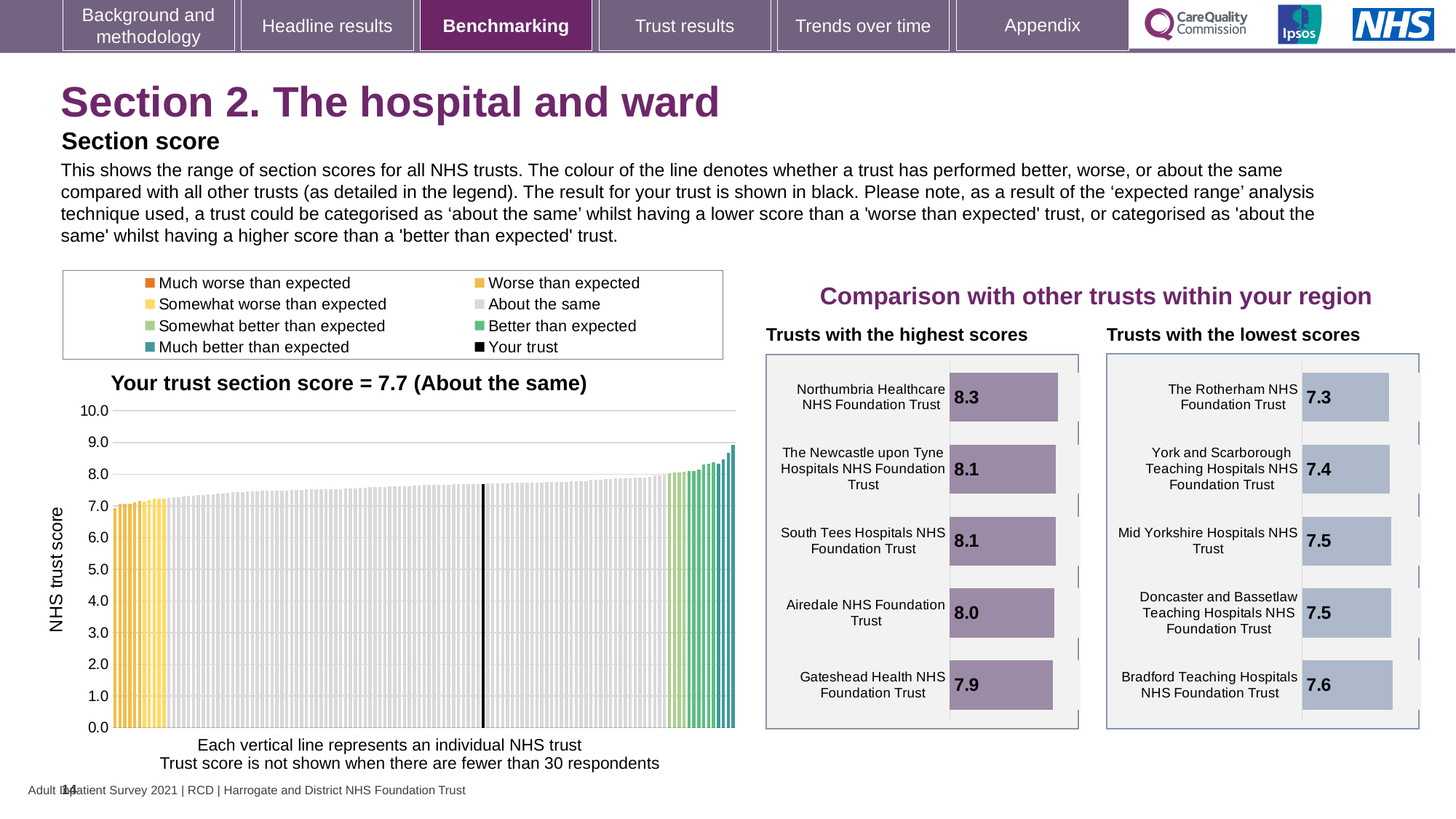
In the 'Trusts with the highest scores' chart, which trust has the highest score? Northumbria Healthcare NHS Foundation Trust In the main 'NHS trust score' chart, is the value for your trust greater or less than 5.0? greater In the main 'NHS trust score' chart, what is your trust's section score? 7.7 In the 'Trusts with the highest scores' chart, which has the larger score: Airedale NHS Foundation Trust or Gateshead Health NHS Foundation Trust? Airedale NHS Foundation Trust How many entries does the legend of the main 'NHS trust score' chart list? 8 In the 'Trusts with the highest scores' chart, what is the score for Northumbria Healthcare NHS Foundation Trust? 8.3 In the 'Trusts with the lowest scores' chart, which trust has the lowest score? The Rotherham NHS Foundation Trust In the 'Trusts with the lowest scores' chart, what is the difference between the scores of Bradford Teaching Hospitals NHS Foundation Trust and The Rotherham NHS Foundation Trust? 0.3 In the 'Trusts with the highest scores' chart, what is the difference between the scores of Northumbria Healthcare NHS Foundation Trust and Gateshead Health NHS Foundation Trust? 0.4 What kind of chart is the main 'NHS trust score' chart on the left of the slide? Bar chart In the 'Trusts with the lowest scores' chart, what is the score for Bradford Teaching Hospitals NHS Foundation Trust? 7.6 How many trusts are shown in the 'Trusts with the lowest scores' chart? 5